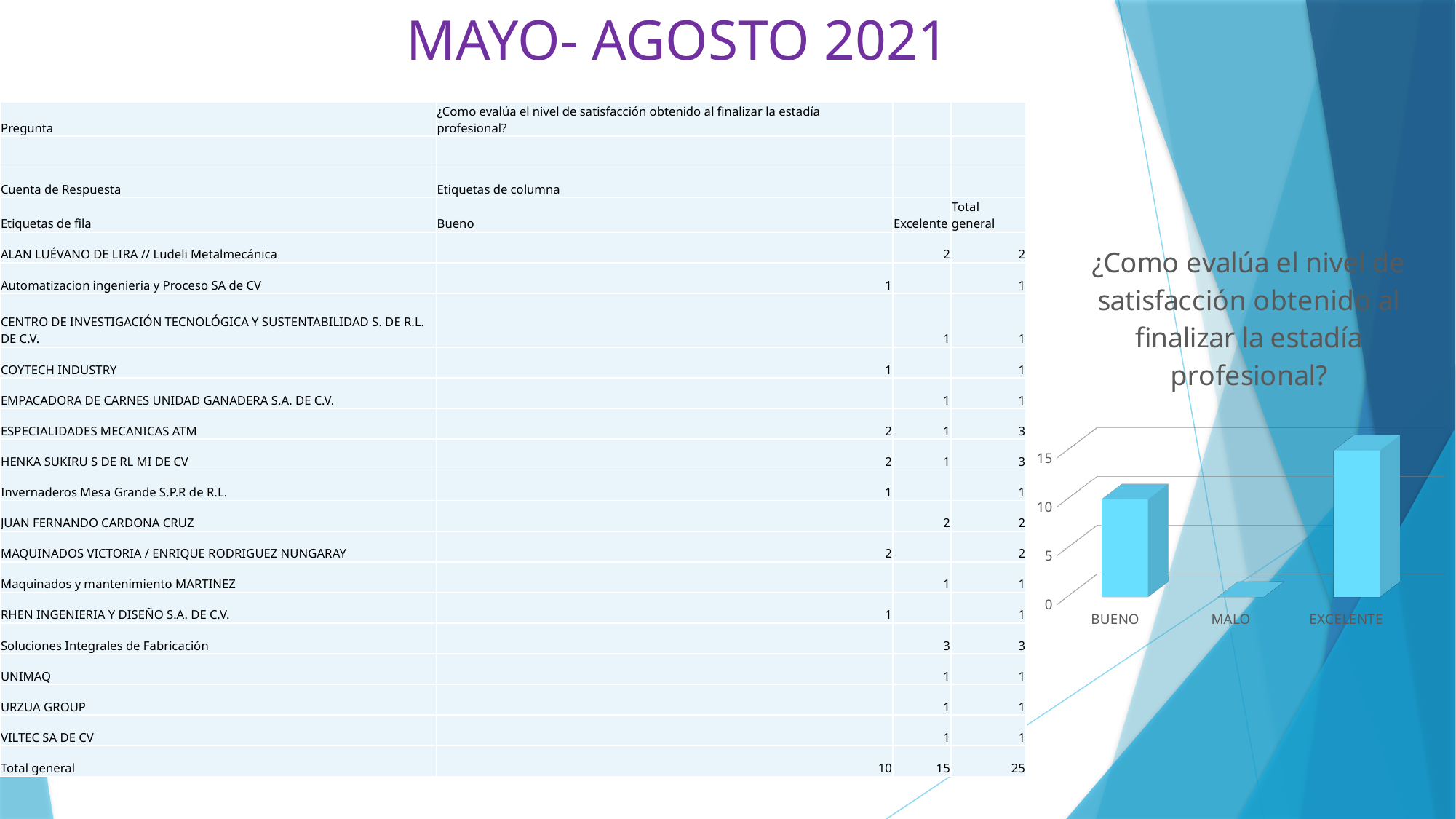
What kind of chart is shown on the slide? bar chart Which is larger in the chart, the value for BUENO or the value for EXCELENTE? EXCELENTE Which category has the lowest bar in the chart? MALO Is the value for BUENO greater or less than 15? less Is the value for EXCELENTE greater or less than 10? greater What is the title of the chart? ¿Como evalúa el nivel de satisfacción obtenido al finalizar la estadía profesional? Is the value for BUENO greater or less than 5? greater What is the highest value labelled on the chart's vertical axis? 15 How many categories are shown on the x axis of the chart? 3 Which category has the highest bar in the chart? EXCELENTE